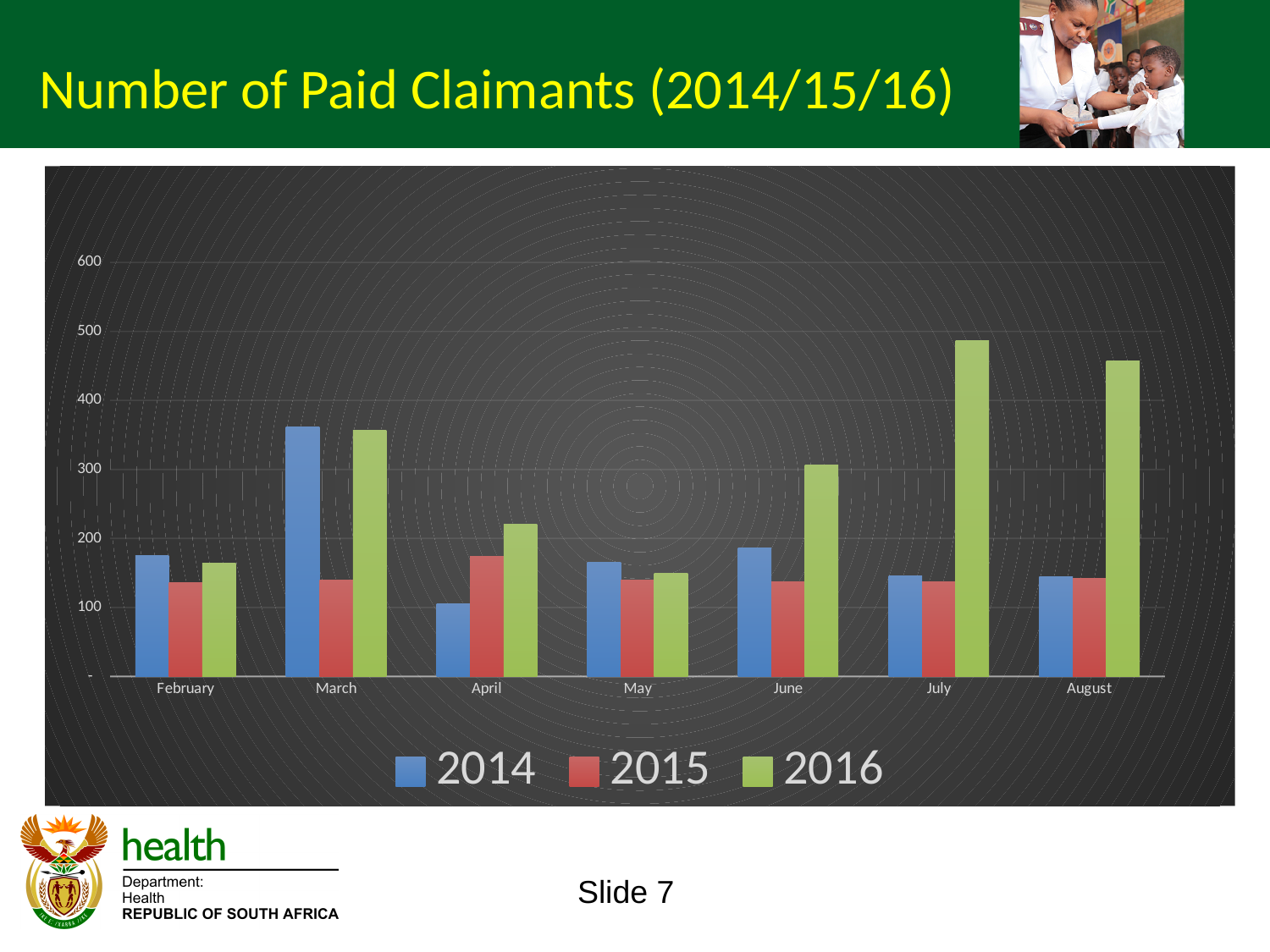
Is the 2014 value for April greater or less than 200? less In June, which series has the larger value, 2014 or 2016? 2016 In April, which series has the larger value, 2014 or 2015? 2015 In which month is the 2014 value highest? March What is the title of the chart on the slide? Number of Paid Claimants (2014/15/16) Is the 2014 value for March greater or less than 300? greater How many months are shown on the x axis? 7 What type of chart is shown on the slide? bar chart How many series does the legend list? 3 Is the 2016 value for July greater or less than 400? greater In which month is the 2014 value lowest? April In which month is the 2016 value highest? July